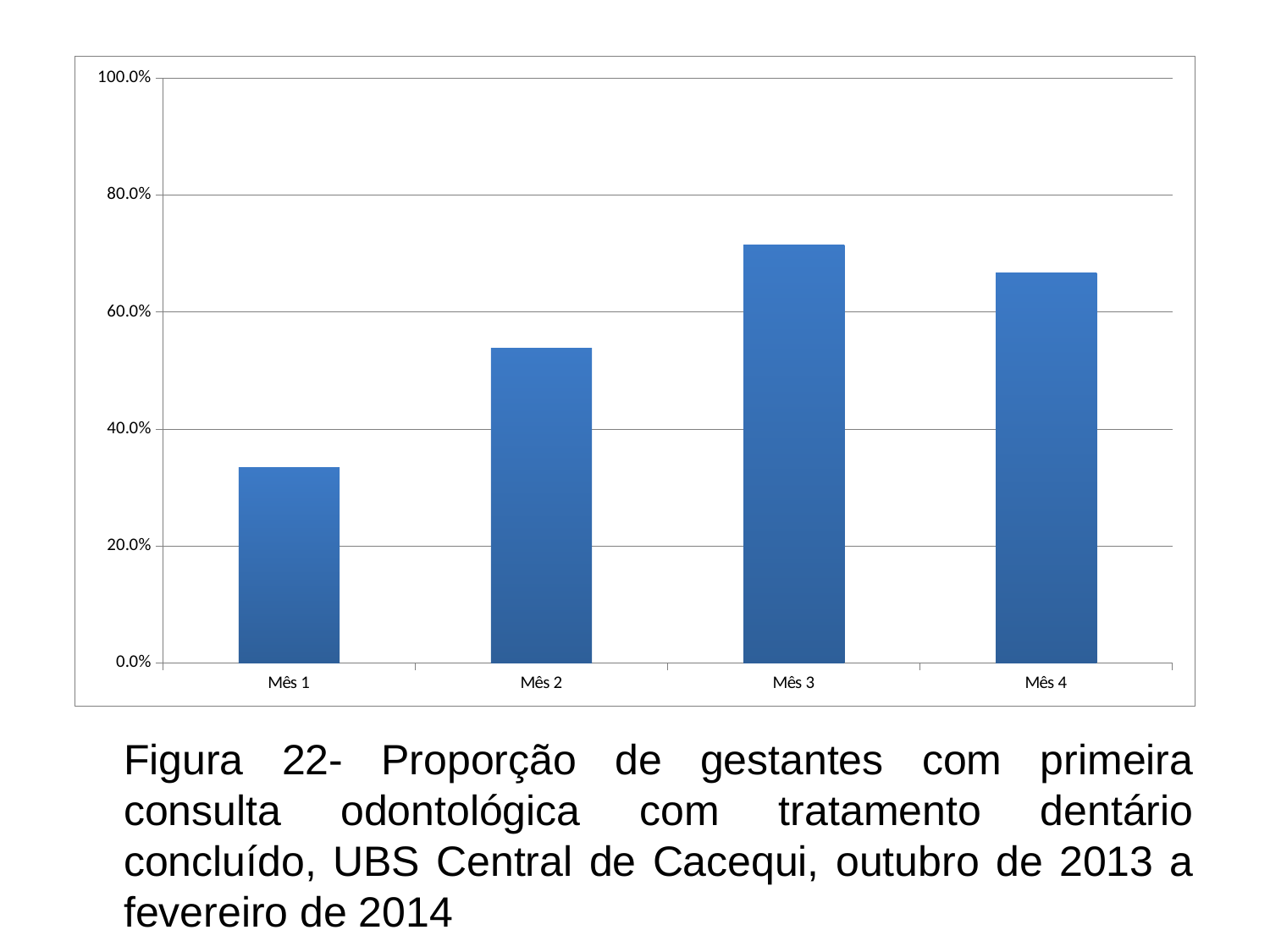
Which is larger, the value for Mês 2 or the value for Mês 4? Mês 4 What figure number is given in the caption below the chart? Figura 22 Which month has the lowest proportion? Mês 1 Which month has the highest proportion? Mês 3 Do the values rise or fall from Mês 1 to Mês 3? rise Is the value for Mês 1 greater or less than 40.0%? less How many months (categories) are plotted on the x axis? 4 What kind of chart is shown on the slide? bar chart Is the value for Mês 2 greater or less than 60.0%? less Is the value for Mês 3 greater or less than 80.0%? less